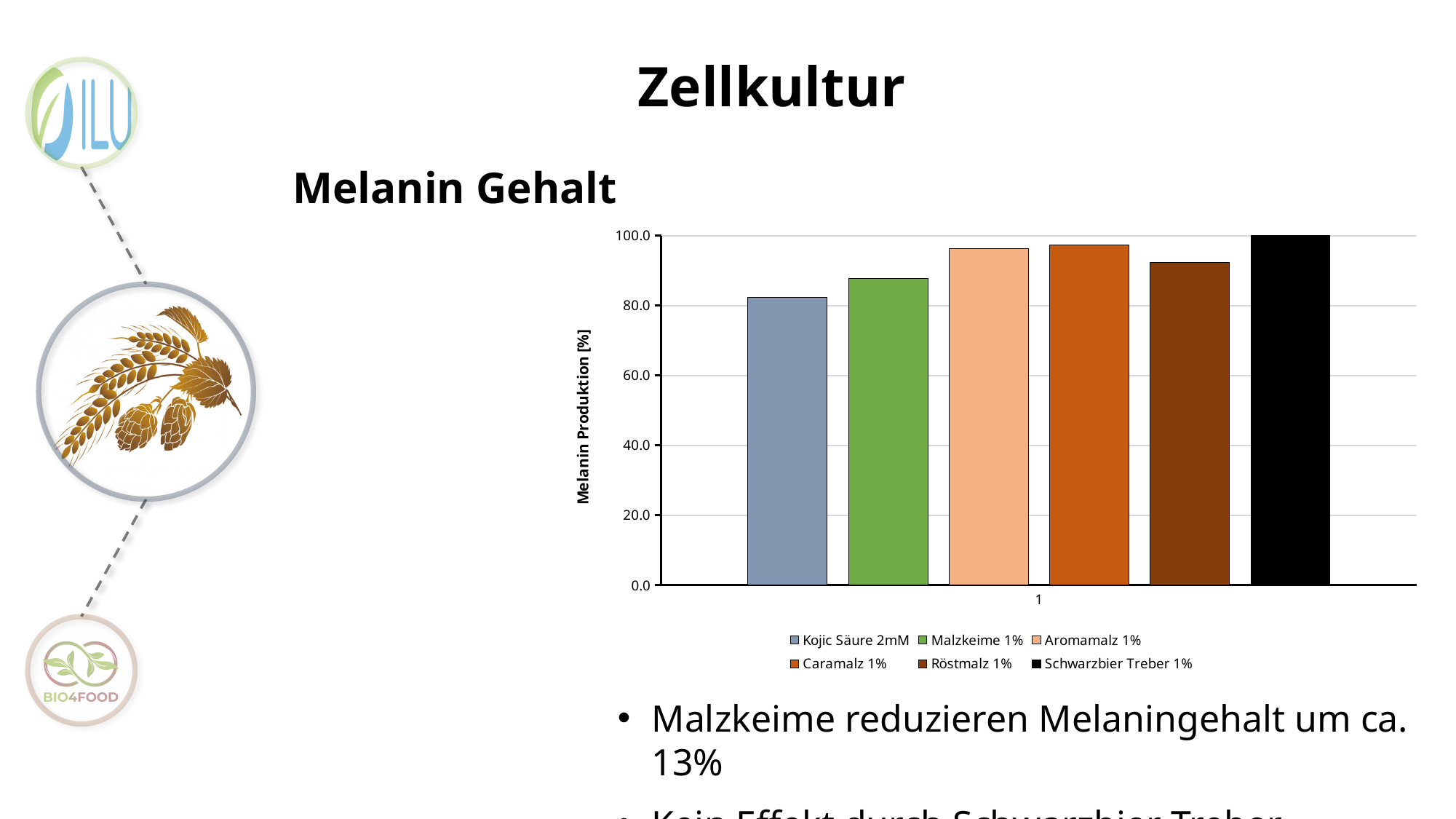
Which series has the lowest melanin production in the chart? Kojic Säure 2mM Is the value for Malzkeime 1% greater or less than 100? less How many series does the legend of the chart list? 6 Which is larger, the value for Kojic Säure 2mM or the value for Malzkeime 1%? Malzkeime 1% What kind of chart is shown on the slide? bar chart What colour is the bar for Schwarzbier Treber 1%? black Which series has the highest melanin production in the chart? Schwarzbier Treber 1% Is the value for Kojic Säure 2mM greater or less than 60? greater Is the value for Röstmalz 1% greater or less than 80? greater What is the label of the vertical axis of the chart? Melanin Produktion [%] Which is larger, the value for Röstmalz 1% or the value for Aromamalz 1%? Aromamalz 1%